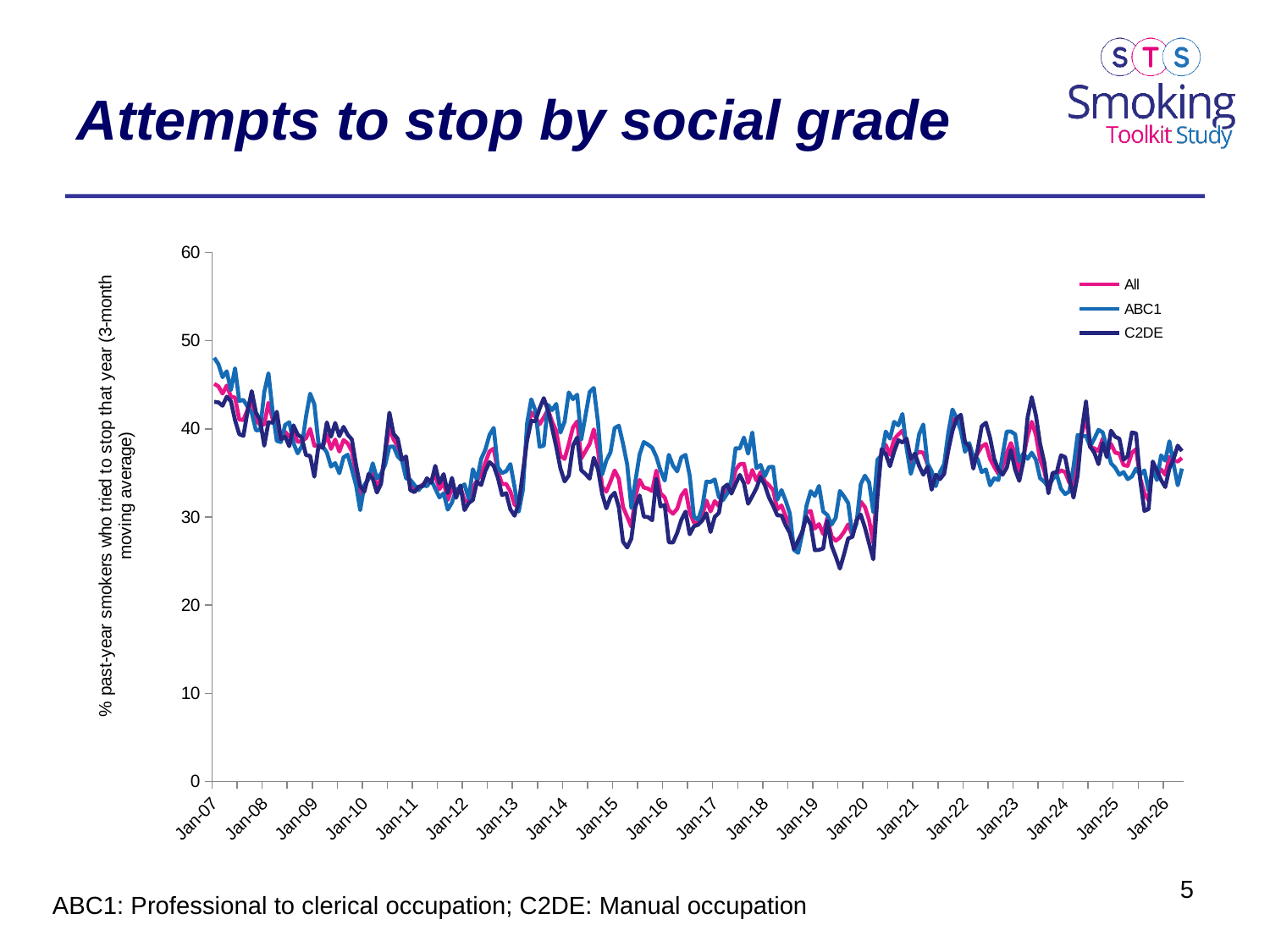
How many year labels are shown on the x axis? 20 How many series does the legend list? 3 What does the y-axis of the chart measure? % past-year smokers who tried to stop that year (3-month moving average) Is the value for All at Jan-10 greater or less than 40? less Which series has the highest value at Jan-07? ABC1 Do the values for All rise or fall between Jan-07 and Jan-10? fall Which series has the lowest value at Jan-07? C2DE What is the title of the slide's chart? Attempts to stop by social grade What kind of chart is shown on the slide? line chart Is the value for ABC1 at Jan-07 greater or less than 40? greater Is the lowest value for C2DE around Jan-20 greater or less than 30? less